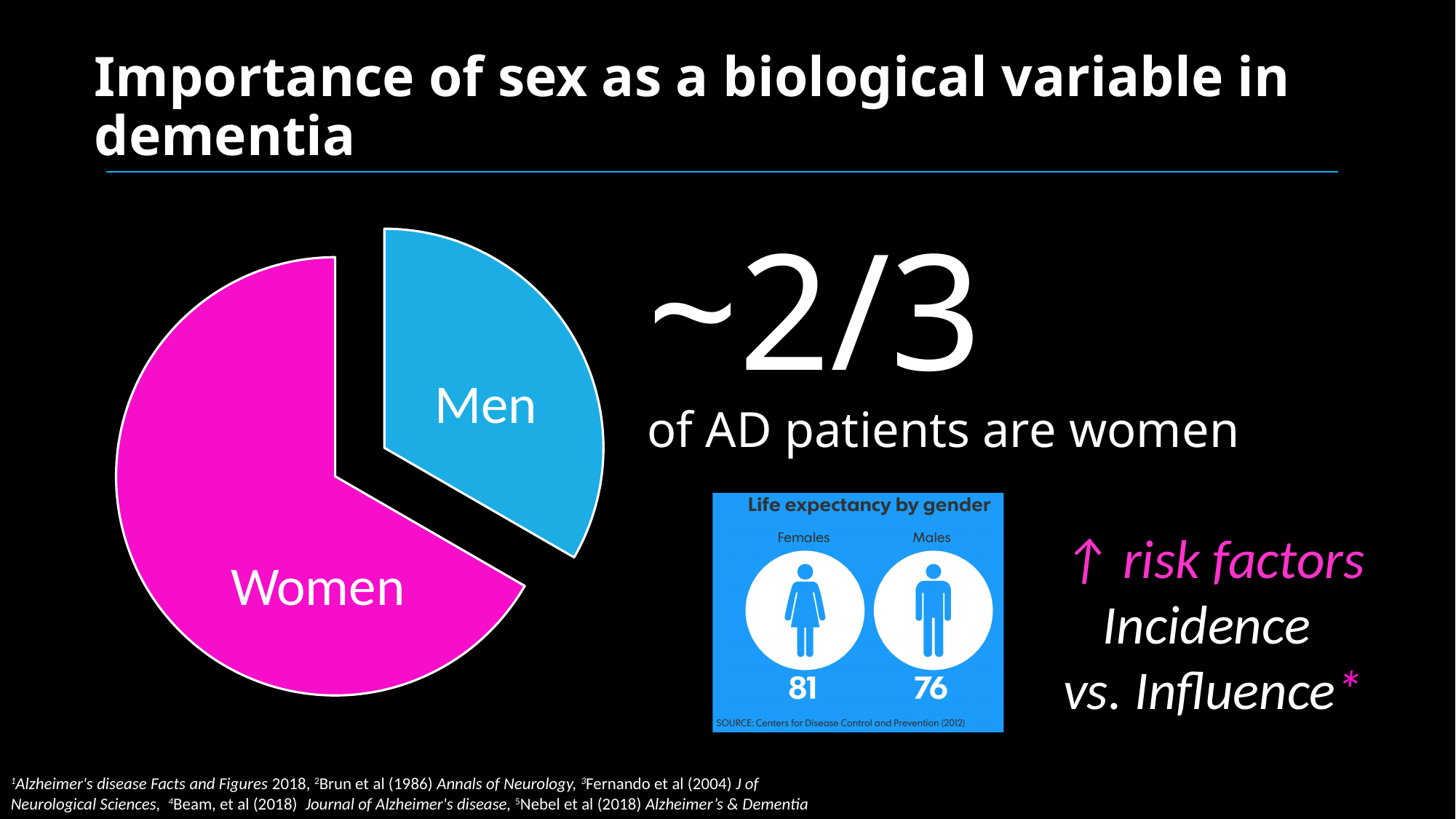
How many slices does the pie chart on the left have? 2 In the 'Life expectancy by gender' figure, which group has the higher value, Females or Males? Females Which slice of the pie chart on the left is the largest? Women Which slice of the pie chart on the left is the smallest? Men In the pie chart on the left, which slice is larger, Women or Men? Women What kind of chart is the chart on the left of the slide? pie chart In the 'Life expectancy by gender' figure, what is the difference between the Females and Males values? 5 In the 'Life expectancy by gender' figure, how many groups are shown? 2 Which slice of the pie chart on the left is pulled out from the rest of the pie? Men In the 'Life expectancy by gender' figure, what is the value for Females? 81 What colour is the Women slice in the pie chart on the left? pink In the 'Life expectancy by gender' figure, what is the value for Males? 76